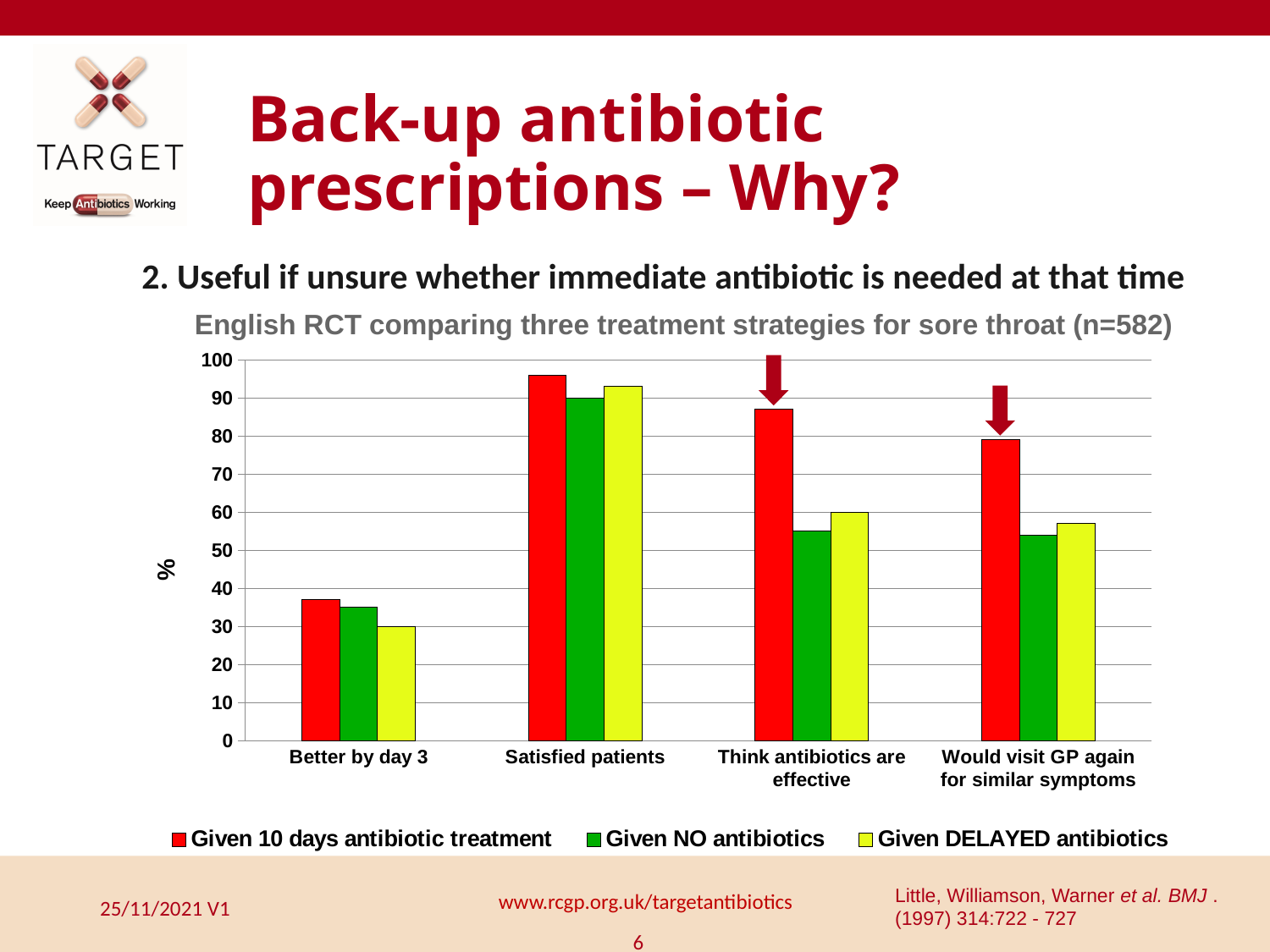
Is the value for 'Given 10 days antibiotic treatment' in the 'Think antibiotics are effective' category greater or less than 80? greater What is the label on the vertical axis of the chart? % How many series does the chart legend list? 3 For the 'Given 10 days antibiotic treatment' series, which category has the highest value? Satisfied patients For the 'Given DELAYED antibiotics' series, which category has the lowest value? Better by day 3 What is the title of the chart? English RCT comparing three treatment strategies for sore throat (n=582) Is the value for 'Given NO antibiotics' in the 'Better by day 3' category greater or less than 40? less Is the value for 'Given NO antibiotics' in the 'Would visit GP again for similar symptoms' category greater or less than 70? less How many categories are shown on the x axis of the chart? 4 In the 'Think antibiotics are effective' category, which is larger: 'Given 10 days antibiotic treatment' or 'Given NO antibiotics'? Given 10 days antibiotic treatment What kind of chart is shown on the slide? bar chart